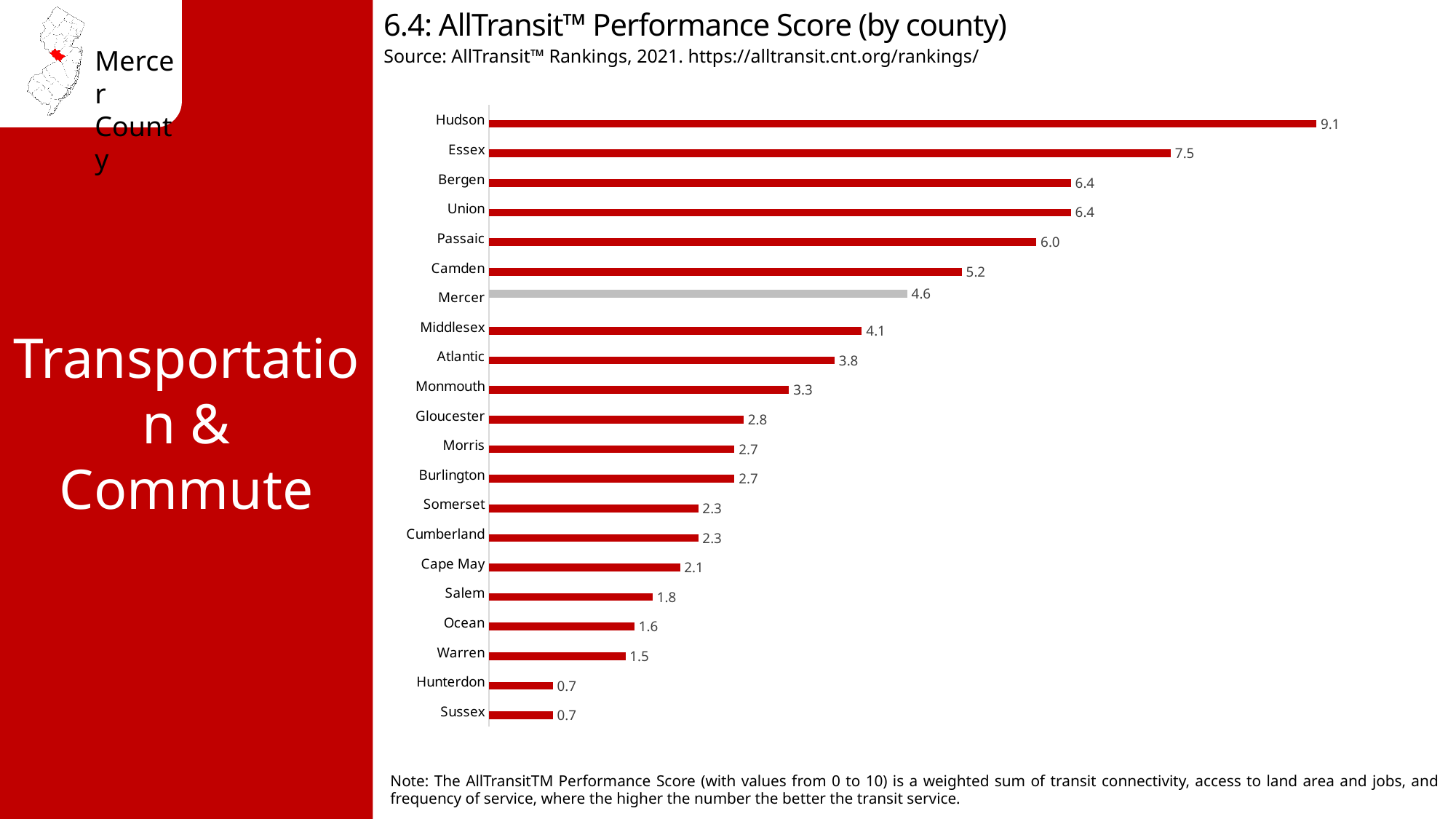
What is the difference between the scores of Hudson and Essex? 1.6 Which county's bar is shown in grey instead of red? Mercer What is the AllTransit Performance Score for Monmouth? 3.3 Which has a higher AllTransit Performance Score, Passaic or Camden? Passaic How many counties are shown on the chart? 21 What is the difference between the scores of Mercer and Middlesex? 0.5 What is the AllTransit Performance Score for Mercer County? 4.6 Which has a higher AllTransit Performance Score, Atlantic or Gloucester? Atlantic What is the AllTransit Performance Score for Camden? 5.2 What type of chart is used to show the AllTransit Performance Scores? Bar chart What is the lowest AllTransit Performance Score shown on the chart? 0.7 Which county has the highest AllTransit Performance Score? Hudson